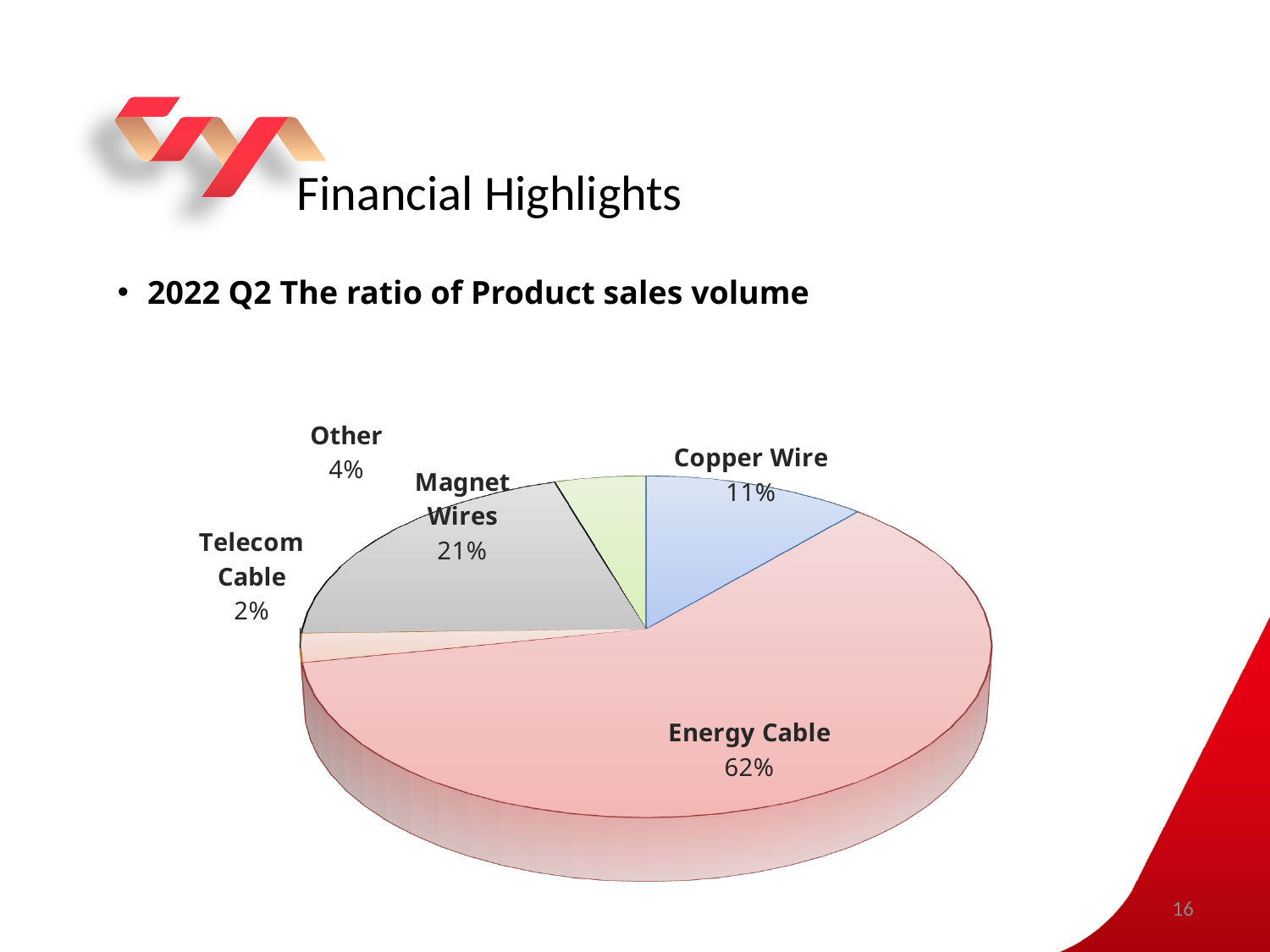
Which has a larger share, Magnet Wires or Copper Wire? Magnet Wires What is the difference in percentage points between Copper Wire and Other? 7 What is the value shown for Copper Wire? 11% What type of chart is shown on the slide? Pie chart How many percentage points larger is Energy Cable's share than Magnet Wires' share? 41 Which product category has the largest share of sales volume? Energy Cable What share does Telecom Cable have? 2% What percentage is labelled for Other? 4% How many product categories are shown in the pie chart? 5 What percentage of the pie is Magnet Wires? 21% What share of product sales volume does Energy Cable account for? 62% Which product category has the smallest share of sales volume? Telecom Cable